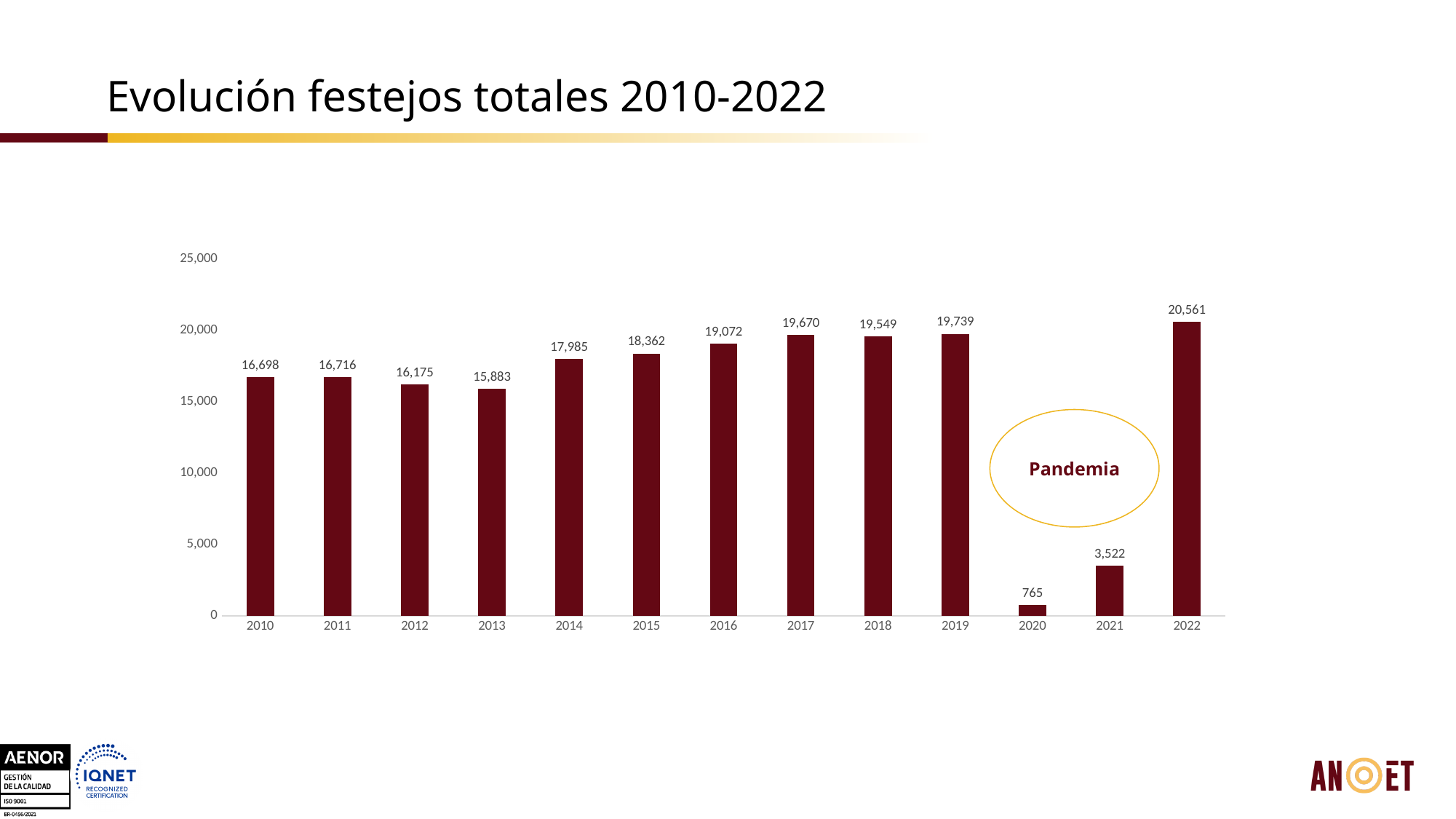
What is the value for 2010? 16,698 What is the difference between the values for 2022 and 2019? 822 Which is larger, the value for 2017 or the value for 2018? 2017 Which year has the lowest value? 2020 What is the value for 2022? 20,561 What kind of chart is this? bar chart What is the difference between the values for 2021 and 2020? 2,757 Is the value for 2014 greater or less than 15,000? greater Which year has the highest value? 2022 How many years are shown on the x axis? 13 What word is written inside the circle drawn over the 2020 and 2021 bars? Pandemia What is the value for 2020? 765